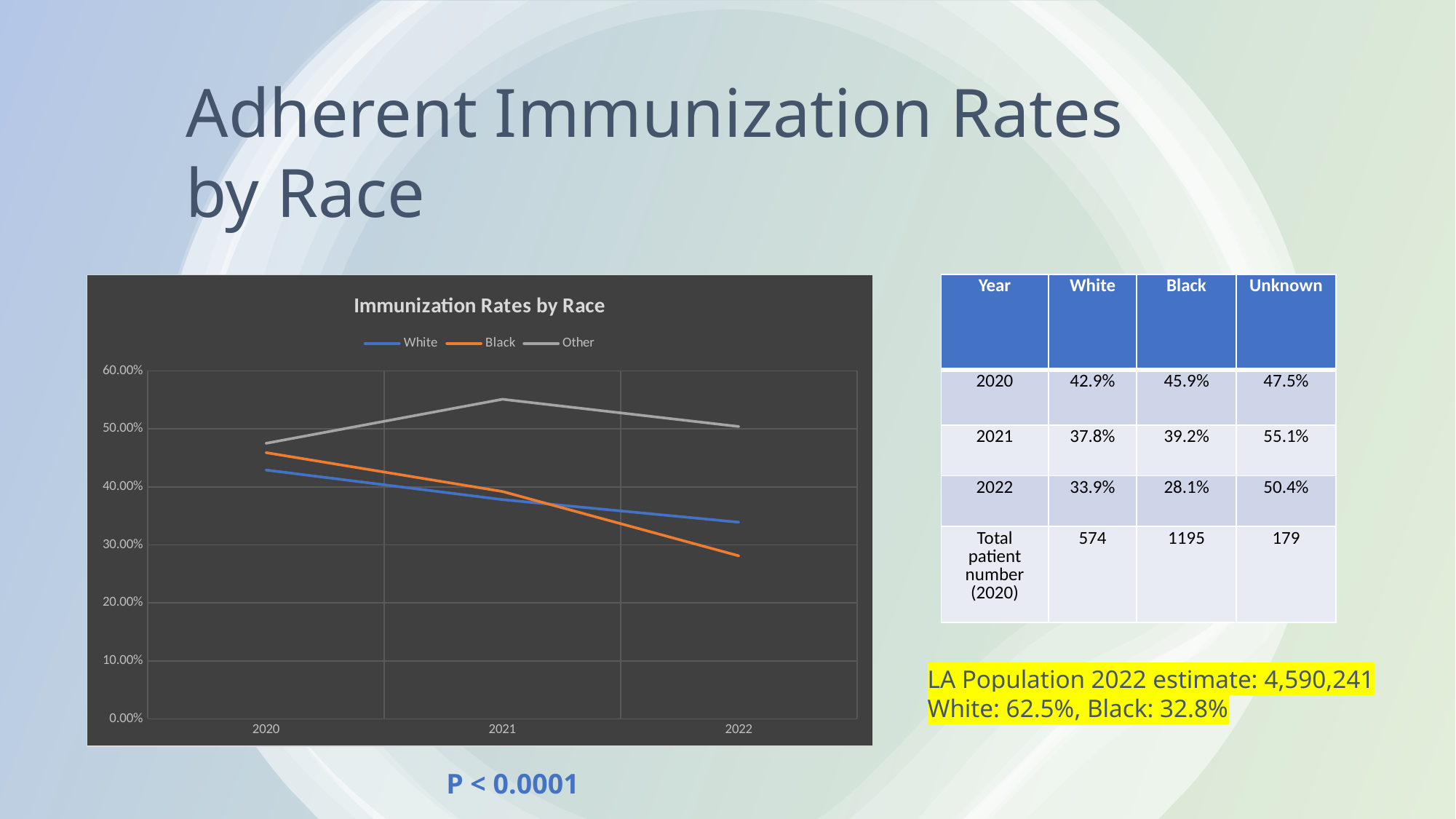
Is the value for the Other series in 2021 greater or less than 50.00%? greater Which series has the lowest value in 2022? Black Which series has the highest value in 2022? Other Is the value for the Black series in 2022 greater or less than 30.00%? less Does the Black series rise or fall from 2020 to 2022? fall What is the title of the chart? Immunization Rates by Race How many series does the legend of the Immunization Rates by Race chart list? 3 What kind of chart is shown on the slide? line chart Does the White series rise or fall from 2020 to 2022? fall What is the immunization rate for White in 2020? 42.9% In 2020, which is higher, the White series or the Black series? Black How many years are plotted along the x axis of the chart? 3